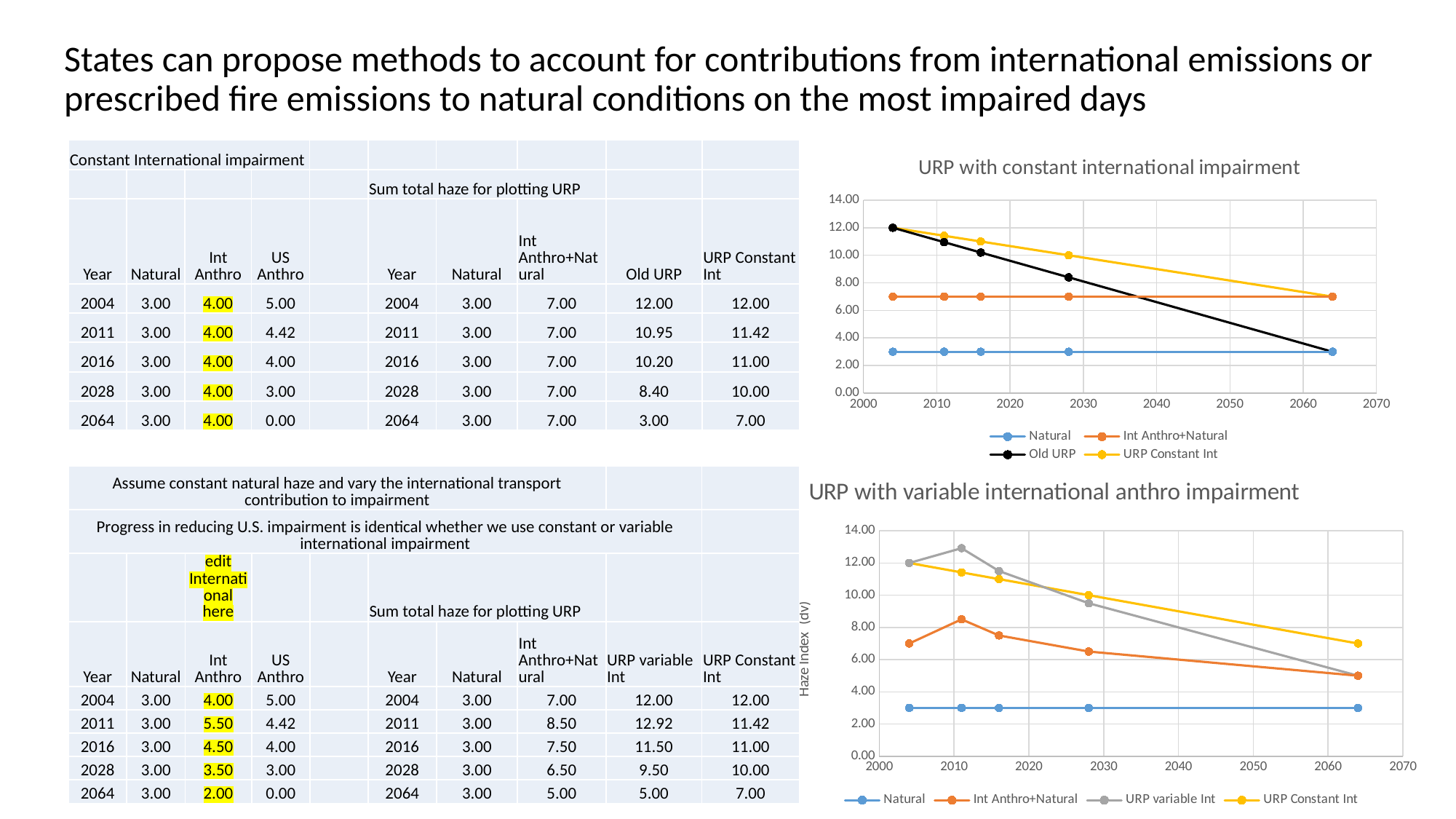
In the 'URP with variable international anthro impairment' chart, does the Natural series rise or fall along the x axis? neither, it stays flat In the 'URP with variable international anthro impairment' chart, which series has the highest value at 2011? URP variable Int What kind of chart is 'URP with constant international impairment'? line chart In the 'URP with variable international anthro impairment' chart, is the value for URP variable Int at 2011 greater or less than 12.00? greater In the 'URP with constant international impairment' chart, does the Old URP series rise or fall along the x axis? fall What is the y-axis label of the 'URP with variable international anthro impairment' chart? Haze Index (dv) In the 'URP with variable international anthro impairment' chart, which is larger at 2064: URP Constant Int or URP variable Int? URP Constant Int In the 'URP with constant international impairment' chart, is the value for Old URP at 2064 greater or less than 4.00? less How many series does the legend of the 'URP with variable international anthro impairment' chart list? 4 How many series does the legend of the 'URP with constant international impairment' chart list? 4 In the 'URP with constant international impairment' chart, what is the value of Old URP at 2004? 12.00 In the 'URP with constant international impairment' chart, how many data points does the Old URP series have? 5